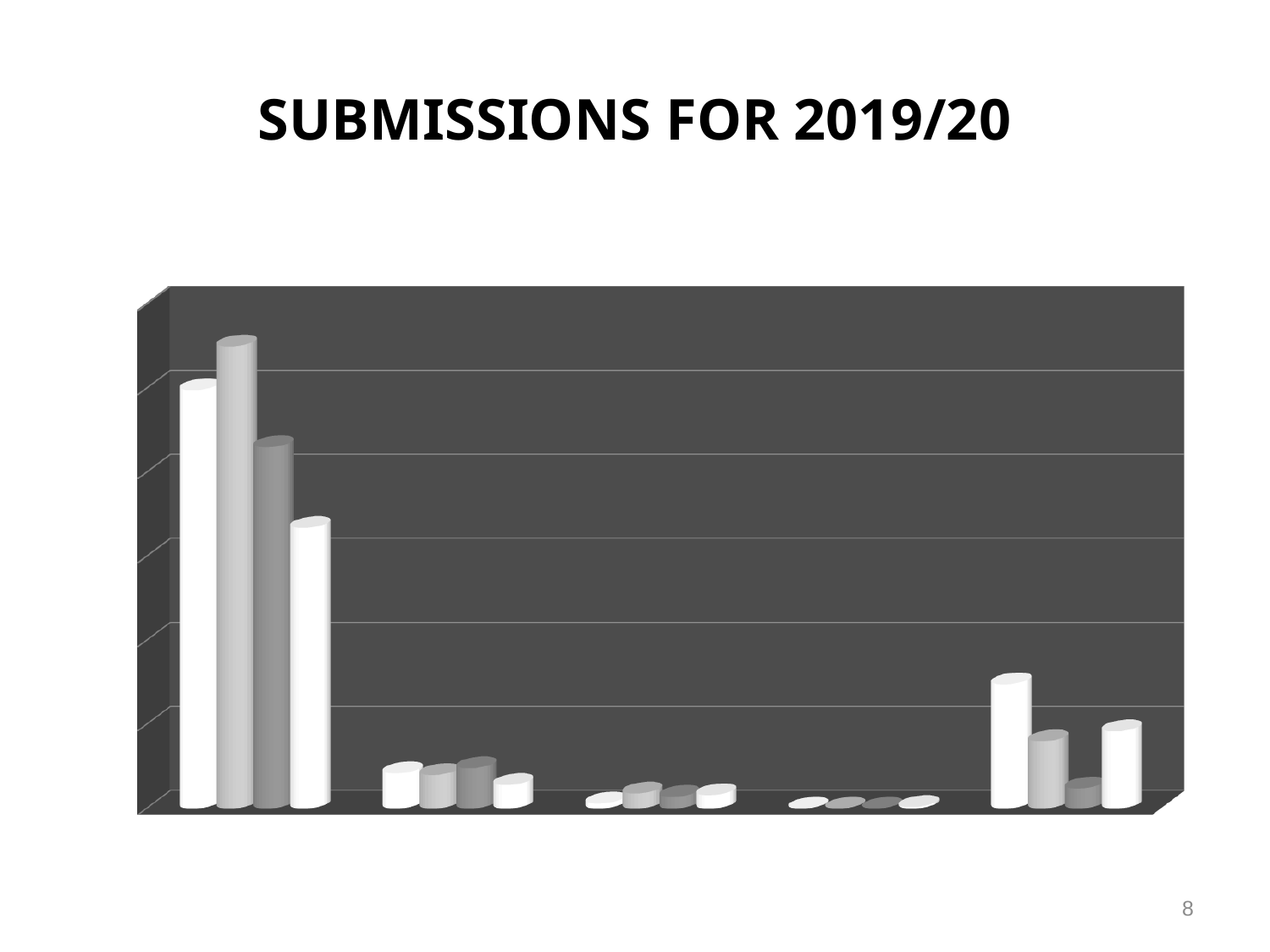
Which group of bars, counting from the left, has the lowest values in the chart? the fourth group Are the bars in the first (leftmost) group taller or shorter than the bars in the last (rightmost) group? taller How many bars are there in each group of the chart? 4 Which group of bars, counting from the left, contains the tallest bar in the chart? the first group How many groups of bars are plotted in the chart? 5 Within the first (leftmost) group of bars, which bar is the tallest? the second bar Does the chart display a legend? No What is the title of the chart on the slide? SUBMISSIONS FOR 2019/20 What kind of chart is shown on the slide? bar chart